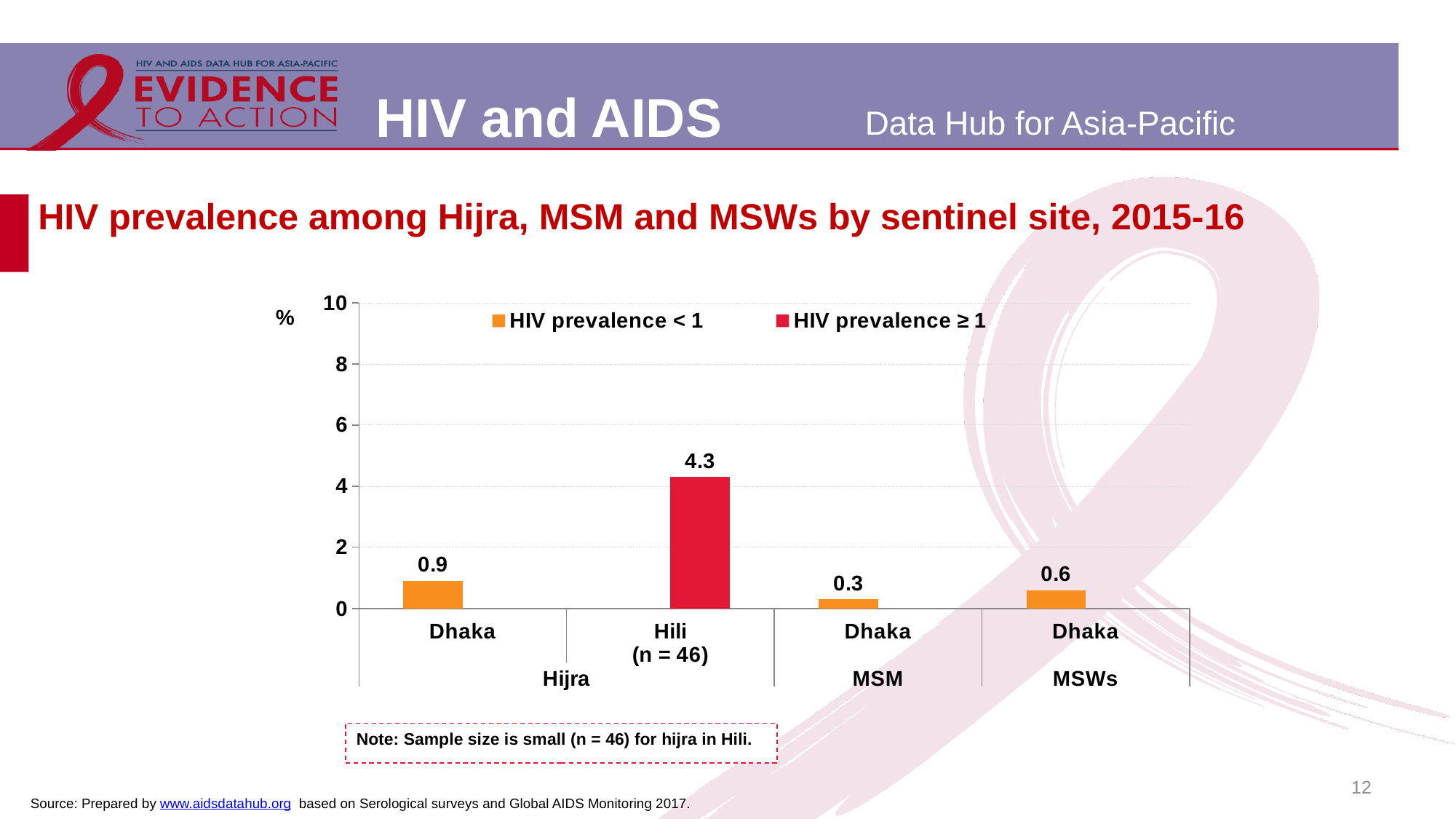
What type of chart is shown on the slide? Bar chart What is the difference in HIV prevalence between Hijra in Hili and Hijra in Dhaka? 3.4 What is the HIV prevalence among MSM in Dhaka? 0.3 Which sentinel site and group has the lowest HIV prevalence? Dhaka (MSM) What is the HIV prevalence among Hijra in Hili (n = 46)? 4.3 Is the HIV prevalence for Hijra in Hili greater or less than 4? greater What is the HIV prevalence among Hijra in Dhaka? 0.9 Which has a higher HIV prevalence: MSWs in Dhaka or MSM in Dhaka? MSWs in Dhaka How many bars are plotted in the chart? 4 How many series does the legend list? 2 What is the HIV prevalence among MSWs in Dhaka? 0.6 Which sentinel site and group has the highest HIV prevalence? Hili (Hijra)